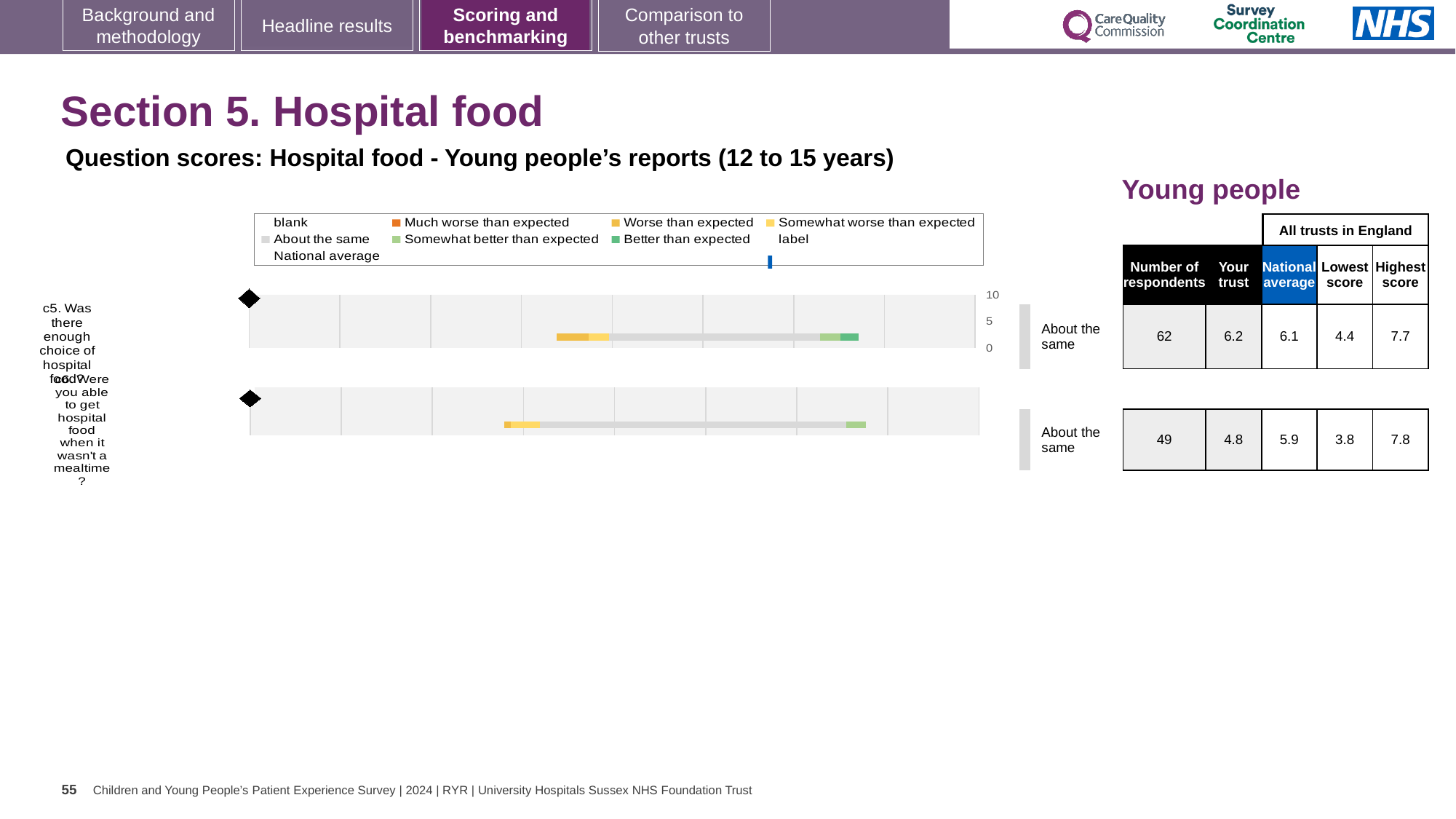
What is the 'Your trust' score for c5 'Was there enough choice of hospital food?' 6.2 What is the lowest score across all trusts in England for c6 'Were you able to get hospital food when it wasn't a mealtime?' 3.8 Which question has more respondents, c5 or c6? c5. Was there enough choice of hospital food? How many questions (categories) are plotted in the hospital food chart? 2 What kind of chart is used to show the question scores for hospital food? bar chart What is the difference between the highest and lowest trust scores for c5 'Was there enough choice of hospital food?' 3.3 What is the maximum value shown on the chart's score axis? 10 What is the national average score for c6 'Were you able to get hospital food when it wasn't a mealtime?' 5.9 What is the benchmark category shown for c6 'Were you able to get hospital food when it wasn't a mealtime?' About the same Which legend entry is shown in dark orange in the hospital food chart? Much worse than expected Which question has the higher 'Your trust' score, c5 or c6? c5. Was there enough choice of hospital food? How many respondents answered c5 'Was there enough choice of hospital food?' 62